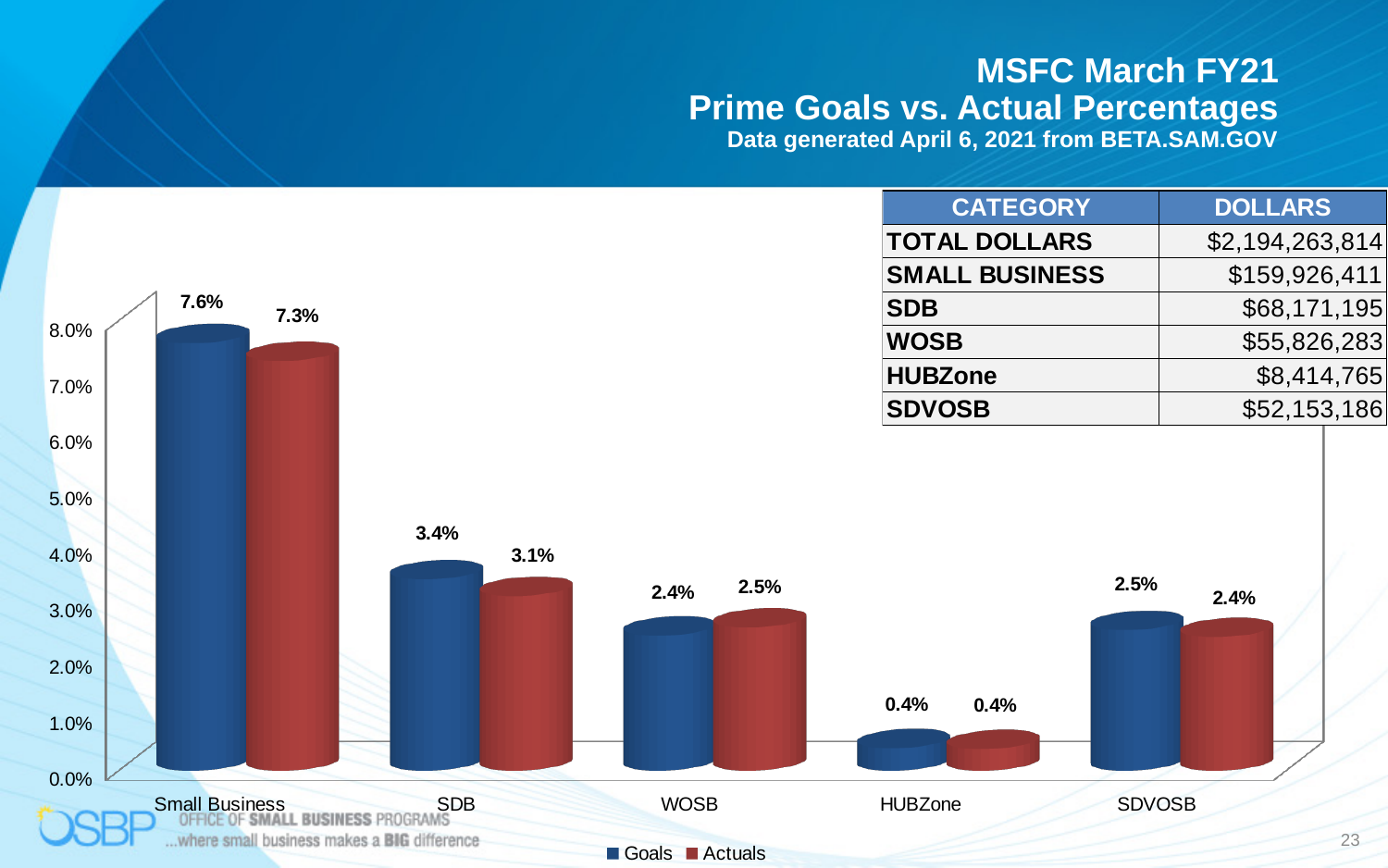
What is the difference between the Goals and Actuals values for Small Business? 0.3% What is the Actuals value for SDB? 3.1% What kind of chart is shown on the slide? Bar chart How many series does the legend list? 2 How many categories are shown on the x axis? 5 Which is larger for WOSB, the Goals value or the Actuals value? Actuals Which category has the lowest Actuals value? HUBZone What is the Goals value for Small Business? 7.6% What is the difference between the Goals and Actuals values for SDB? 0.3% What is the Goals value for HUBZone? 0.4% What is the Actuals value for WOSB? 2.5% Which category has the highest Goals value? Small Business